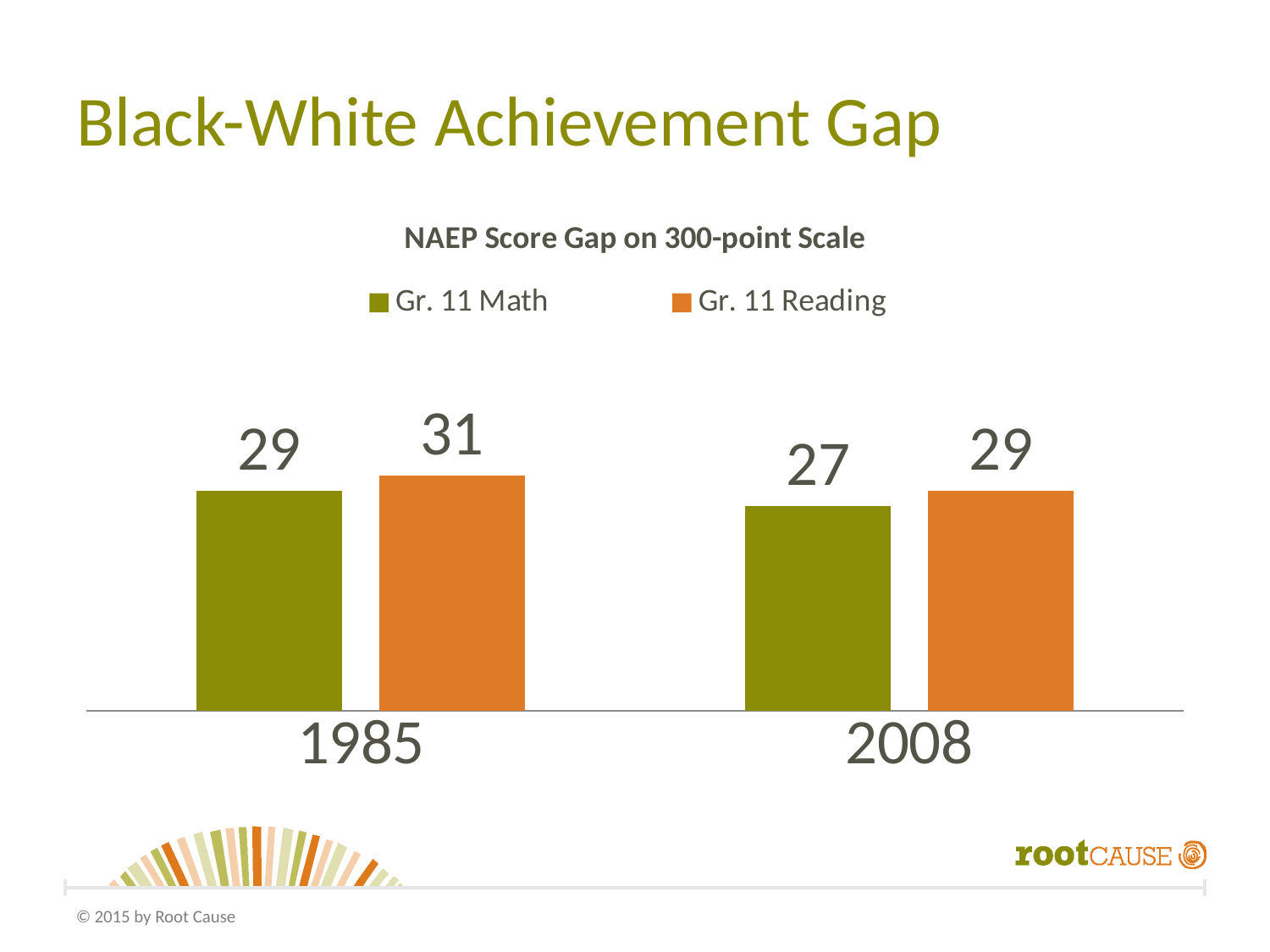
Which is larger in 2008, the Gr. 11 Math gap or the Gr. 11 Reading gap? Gr. 11 Reading What is the Gr. 11 Reading score gap in 1985? 31 What is the Gr. 11 Reading score gap in 2008? 29 What kind of chart is shown on the slide? Bar chart What is the difference between the Gr. 11 Reading and Gr. 11 Math score gaps in 1985? 2 By how much did the Gr. 11 Math score gap change from 1985 to 2008? 2 What is the Gr. 11 Math score gap in 2008? 27 Which bar shows the lowest score gap on the chart? Gr. 11 Math in 2008 Which bar shows the highest score gap on the chart? Gr. 11 Reading in 1985 How many series does the legend list? 2 How many years are shown on the x axis? 2 What is the Gr. 11 Math score gap in 1985? 29